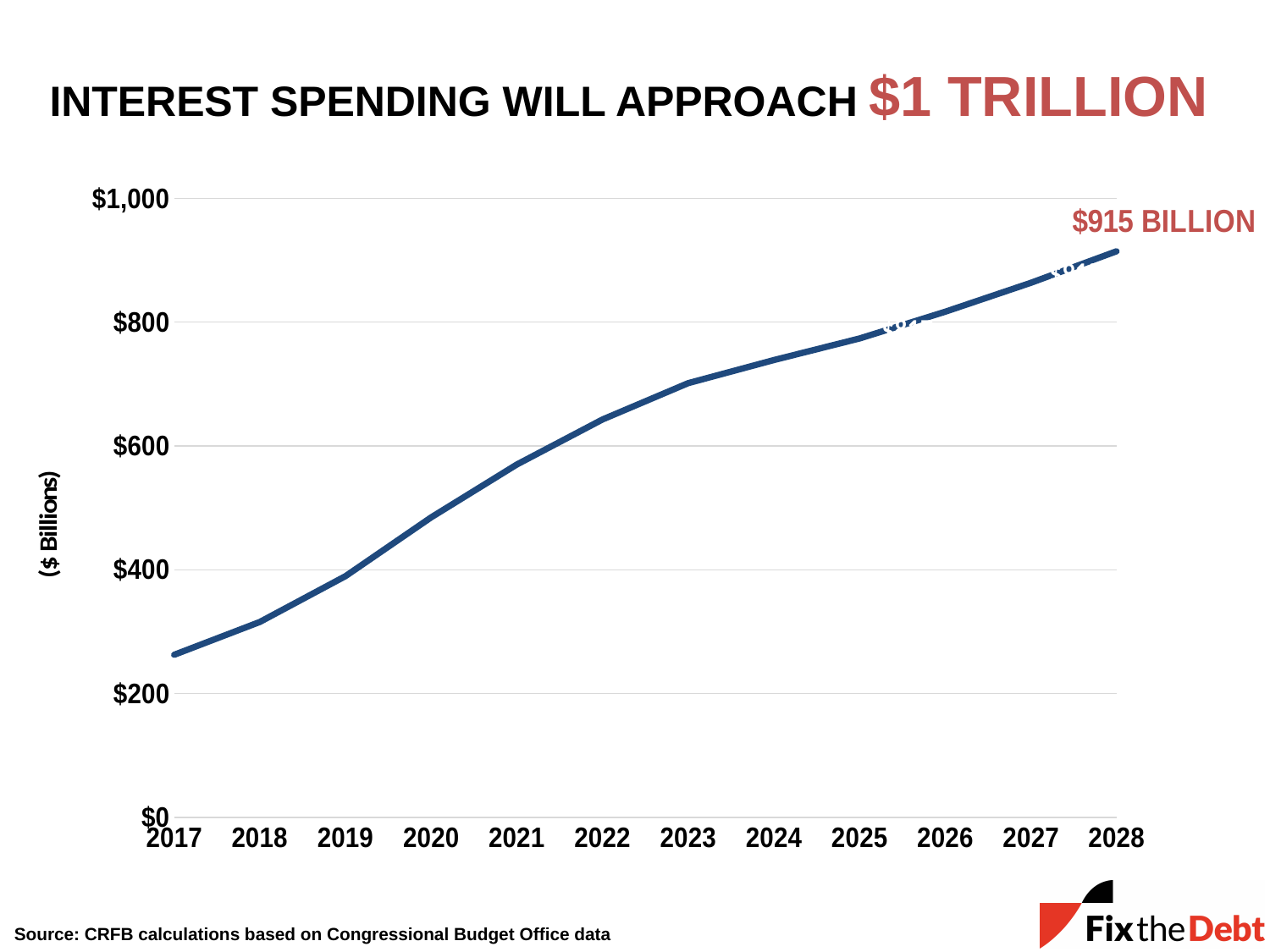
What is the label on the y axis? ($ Billions) How many years are plotted on the x axis? 12 Which year has the highest interest spending? 2028 Which year has the lowest interest spending? 2017 Which year has the larger value, 2020 or 2026? 2026 Is the value for 2022 greater or less than $600? greater Is the value for 2017 greater or less than $400? less What is the value of interest spending in 2028? $915 billion Do the values rise or fall from 2017 to 2028? Rise Is the value for 2027 greater or less than $800? greater What kind of chart is shown on the slide? Line chart